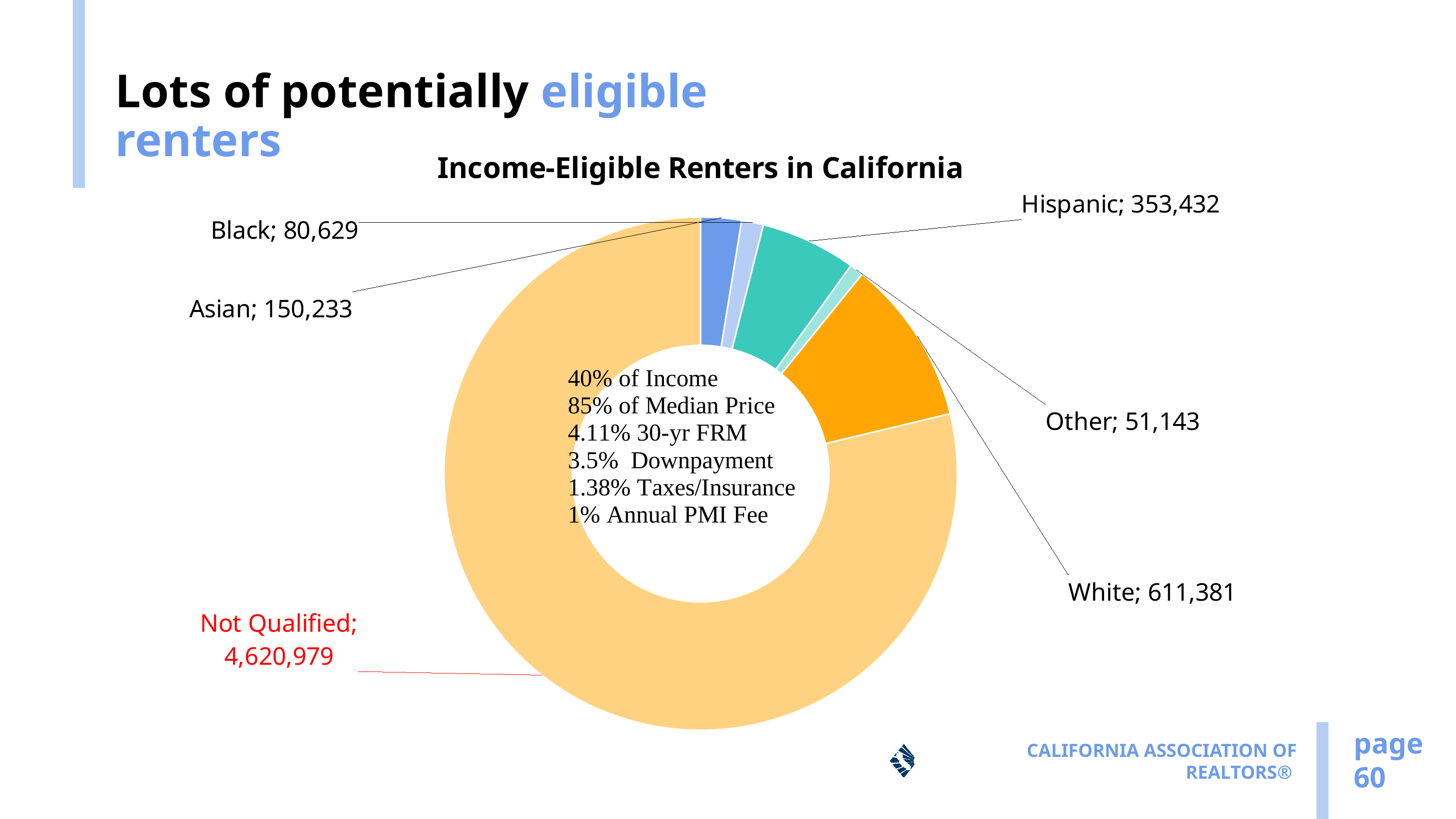
What is the value for White in the Income-Eligible Renters in California chart? 611,381 What is the value for Hispanic in the Income-Eligible Renters in California chart? 353,432 What is the value for Other in the Income-Eligible Renters in California chart? 51,143 What is the difference between the White and Hispanic values in the Income-Eligible Renters in California chart? 257,949 What is the value for Not Qualified in the Income-Eligible Renters in California chart? 4,620,979 Which is larger in the Income-Eligible Renters in California chart, Black or Other? Black Which category has the largest slice in the Income-Eligible Renters in California chart? Not Qualified What is the difference between the Asian and Black values in the Income-Eligible Renters in California chart? 69,604 Which category has the smallest slice in the Income-Eligible Renters in California chart? Other What kind of chart is the Income-Eligible Renters in California chart? Doughnut (pie) chart What is the value for Asian in the Income-Eligible Renters in California chart? 150,233 How many categories are shown in the Income-Eligible Renters in California chart? 6